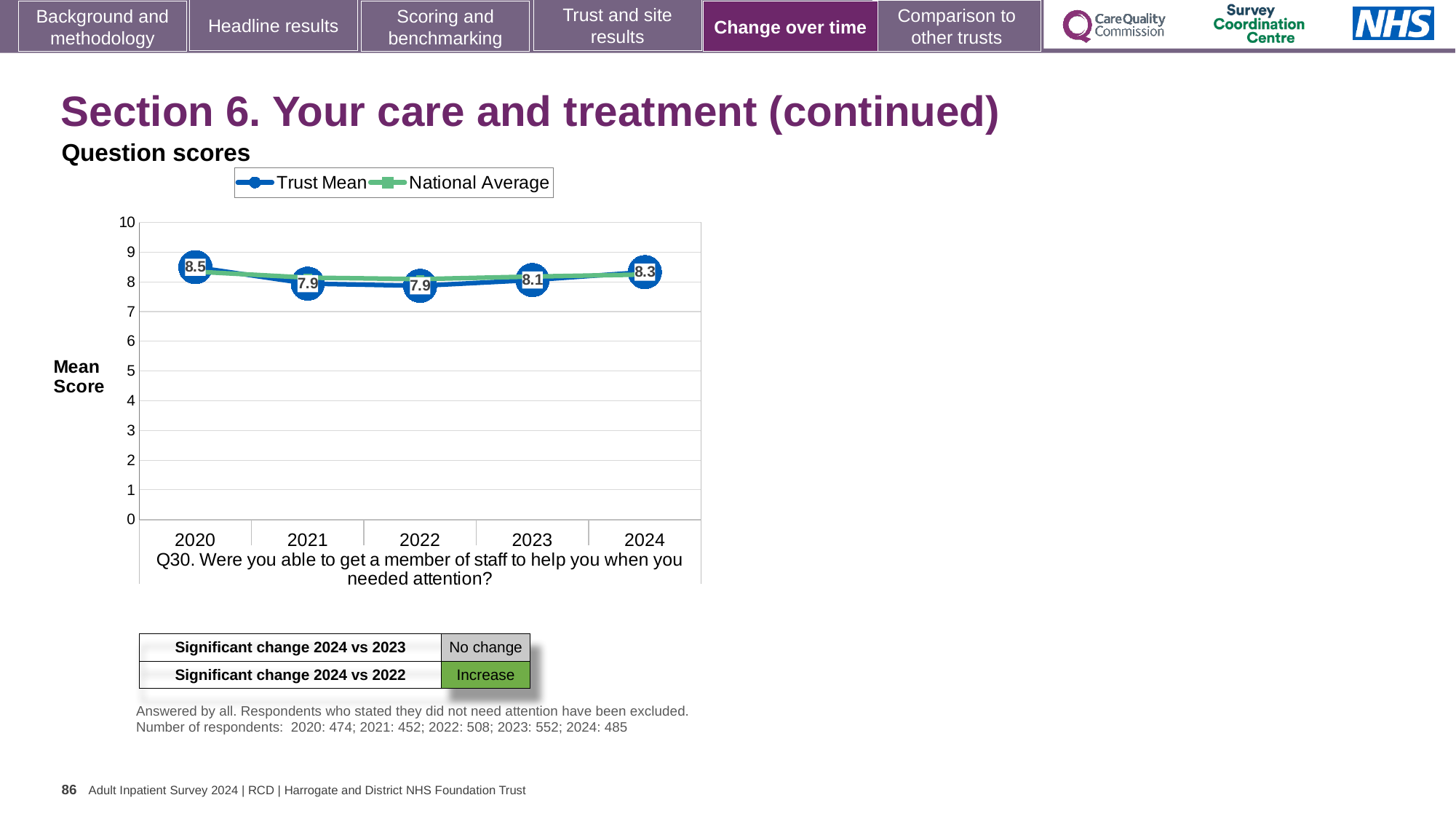
What is the difference between the Trust Mean scores for 2020 and 2021? 0.6 What is the difference between the Trust Mean scores for 2024 and 2022? 0.4 What is the Trust Mean score for 2020? 8.5 In which year is the Trust Mean score highest? 2020 What is the Trust Mean score for 2023? 8.1 How many years are plotted on the x axis? 5 What kind of chart is shown? Line chart Does the Trust Mean score rise or fall from 2022 to 2024? Rise How many series does the legend list? 2 Is the National Average value for 2022 greater or less than 7? greater Which is larger, the Trust Mean score for 2020 or for 2023? 2020 What is the Trust Mean score for 2024? 8.3